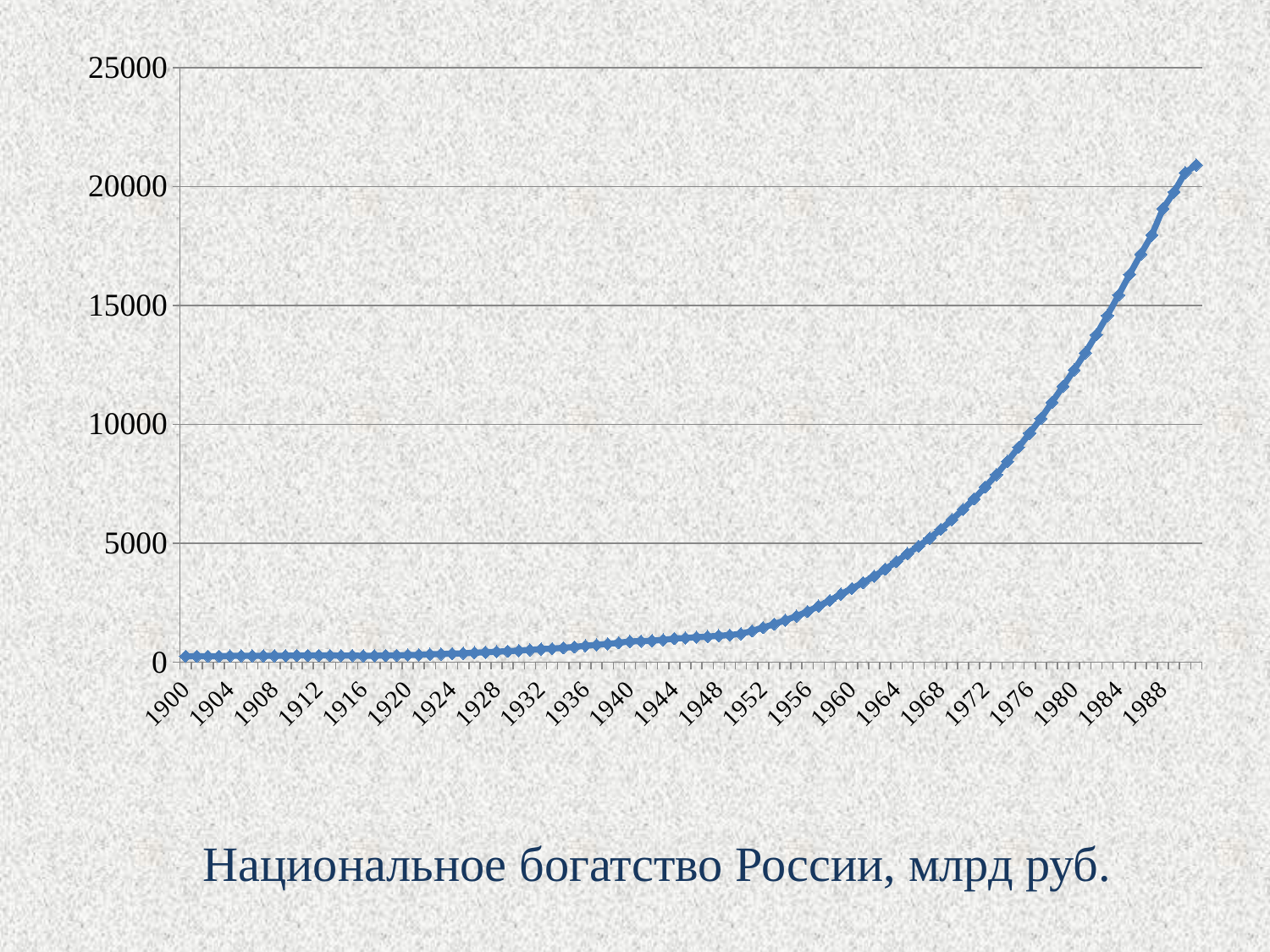
Is the value for 1940 greater or less than 5000? less Is the value for 1972 greater or less than 10000? less Which year has the larger value, 1920 or 1950? 1950 What kind of chart is shown on the slide? Line chart What is the title of the chart? Национальное богатство России, млрд руб. What is the highest value shown on the vertical axis? 25000 Which year has the larger value, 1960 or 1980? 1980 Is the value for 1988 greater or less than 15000? greater How many data series are plotted on the chart? 1 Do the values rise or fall from 1900 to the end of the period? Rise